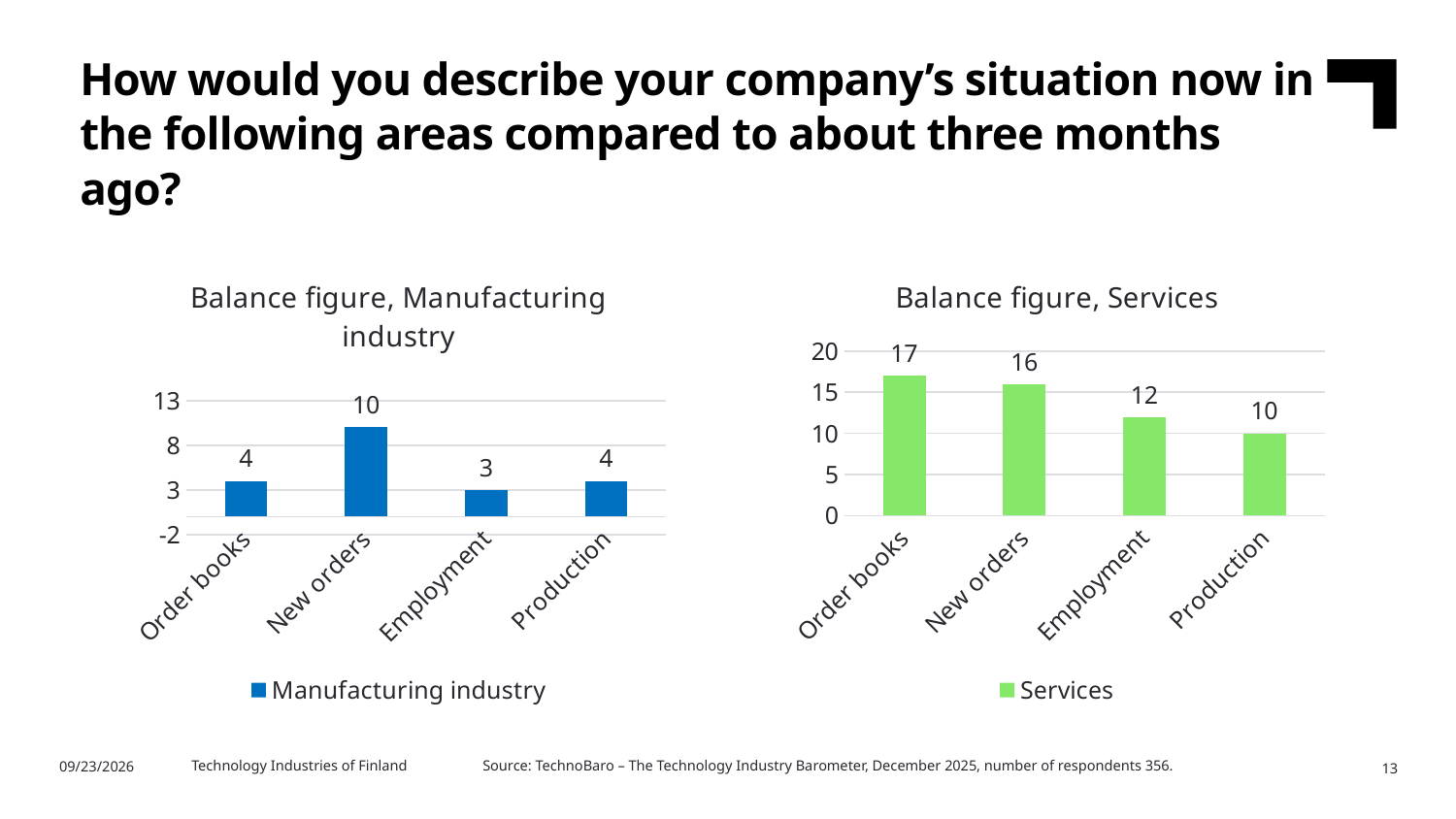
In the 'Balance figure, Manufacturing industry' chart, which category has the highest value? New orders In the 'Balance figure, Manufacturing industry' chart, what is the difference between New orders and Employment? 7 In the 'Balance figure, Services' chart, what is the value for Employment? 12 In the 'Balance figure, Manufacturing industry' chart, which category has the lowest value? Employment What series does the legend of the 'Balance figure, Services' chart list? Services In the 'Balance figure, Services' chart, which is larger, Order books or New orders? Order books What kind of chart is the 'Balance figure, Manufacturing industry' chart? Bar chart In the 'Balance figure, Services' chart, is the value for Employment greater or less than 10? greater In the 'Balance figure, Manufacturing industry' chart, what is the value for New orders? 10 How many categories are shown in the 'Balance figure, Services' chart? 4 In the 'Balance figure, Services' chart, what is the difference between Order books and Production? 7 In the 'Balance figure, Services' chart, which category has the lowest value? Production